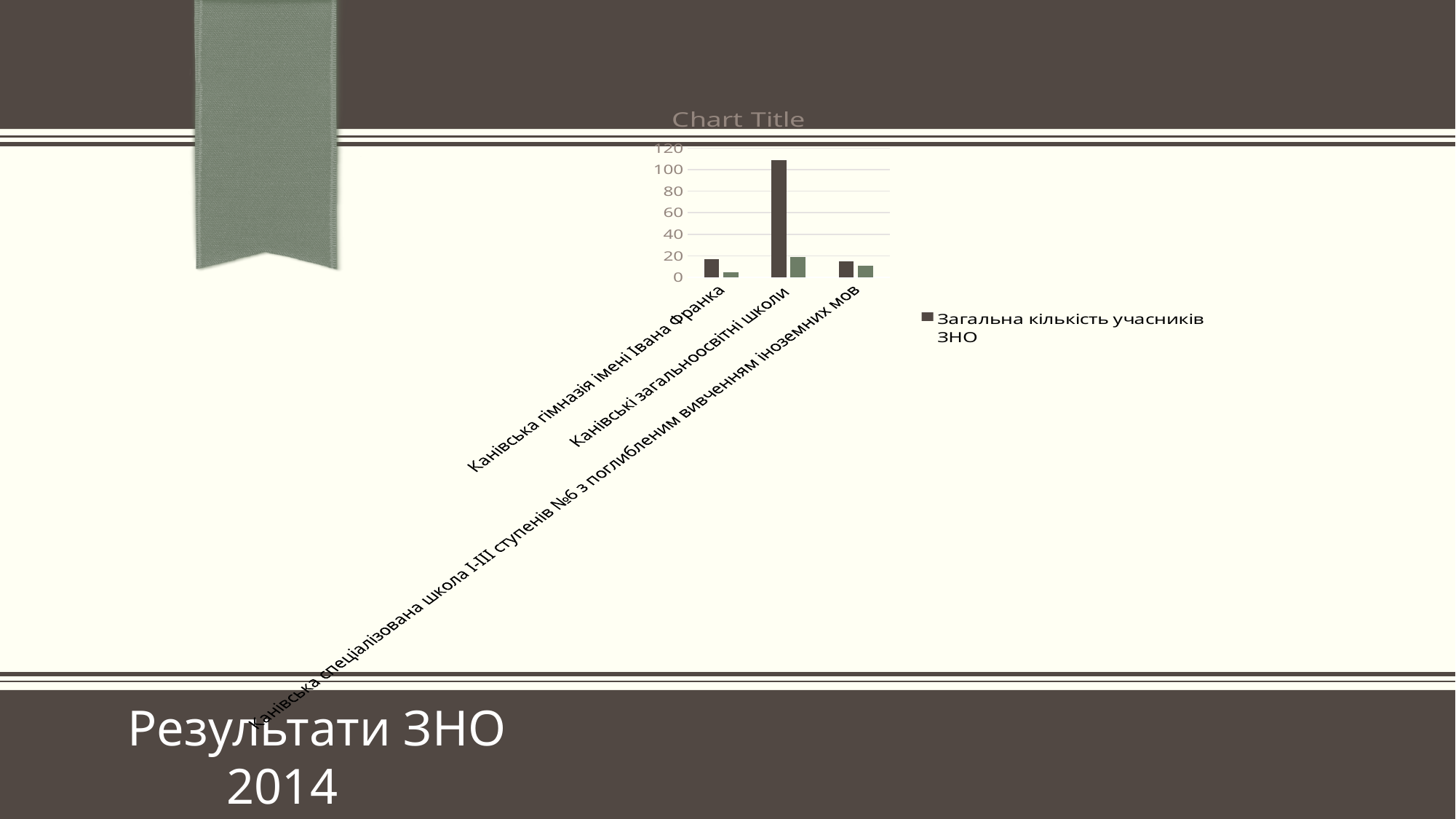
Is the value of 'Загальна кількість учасників ЗНО' for 'Канівська гімназія імені Івана Франка' greater or less than 40? less Is the green bar for 'Канівська гімназія імені Івана Франка' greater or less than 20? less Which is larger: the value of 'Загальна кількість учасників ЗНО' for 'Канівські загальноосвітні школи' or for 'Канівська гімназія імені Івана Франка'? Канівські загальноосвітні школи What is the title of the chart? Chart Title How many series does the chart's legend list? 1 Which category has the tallest green bar? Канівські загальноосвітні школи What kind of chart is shown on the slide? bar chart What is the legend entry shown for the chart? Загальна кількість учасників ЗНО Is the value of 'Загальна кількість учасників ЗНО' for 'Канівські загальноосвітні школи' greater or less than 80? greater Which category has the highest value for the series 'Загальна кількість учасників ЗНО'? Канівські загальноосвітні школи How many categories are shown on the x axis of the chart? 3